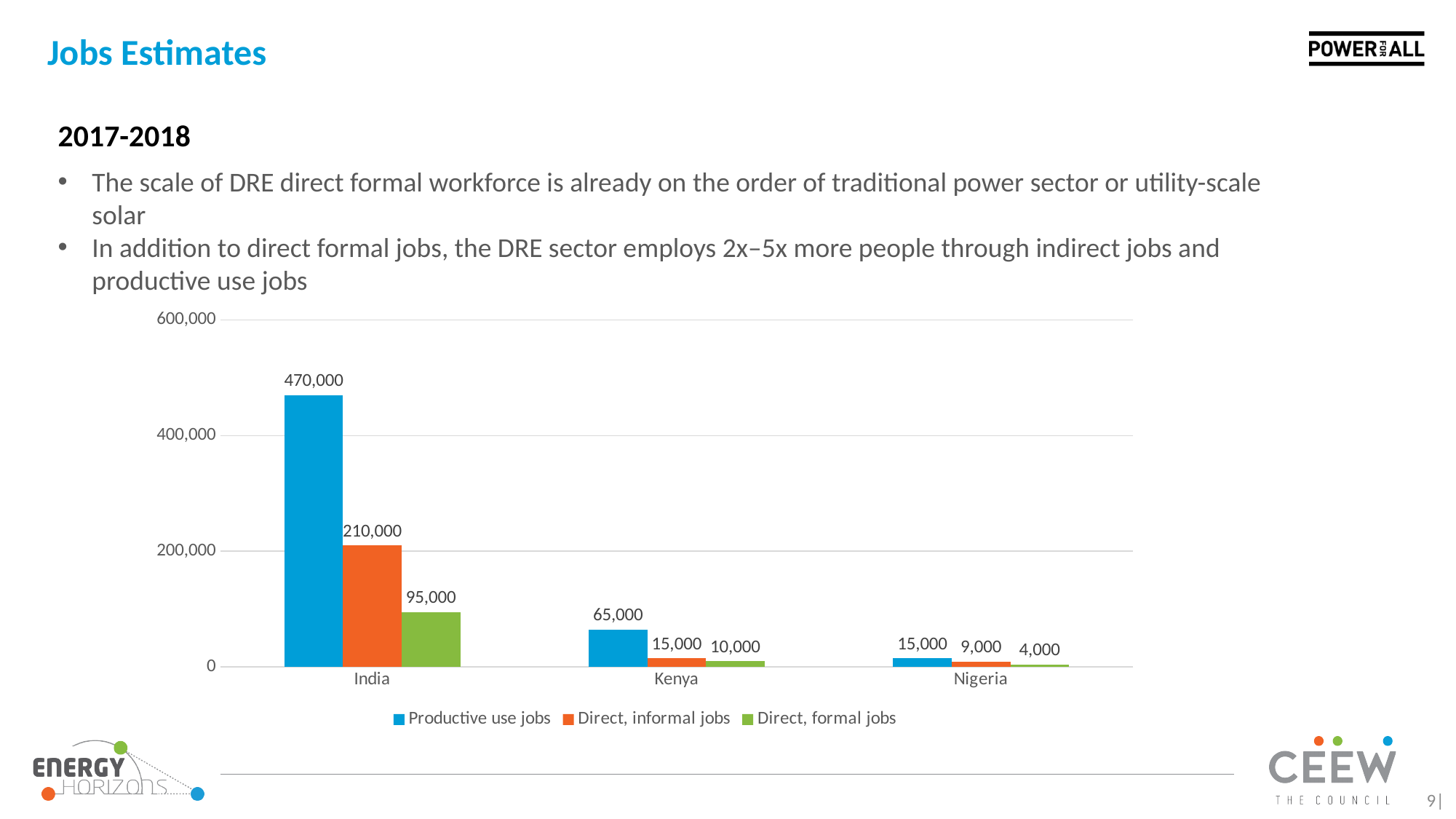
What is the value for Productive use jobs in India? 470,000 Which colour represents Direct, informal jobs in the chart? Orange What is the value for Direct, informal jobs in Kenya? 15,000 Which country has the highest value for Direct, formal jobs? India How many series does the legend list? 3 What kind of chart is shown on the slide? Bar chart Which is larger: Direct, formal jobs in Kenya or Direct, informal jobs in Nigeria? Direct, formal jobs in Kenya Is the value for Productive use jobs in India greater or less than 400,000? greater What is the value for Direct, formal jobs in Nigeria? 4,000 How many countries are shown on the x axis of the chart? 3 What is the difference between Productive use jobs and Direct, informal jobs in India? 260,000 Which country has the lowest value for Productive use jobs? Nigeria